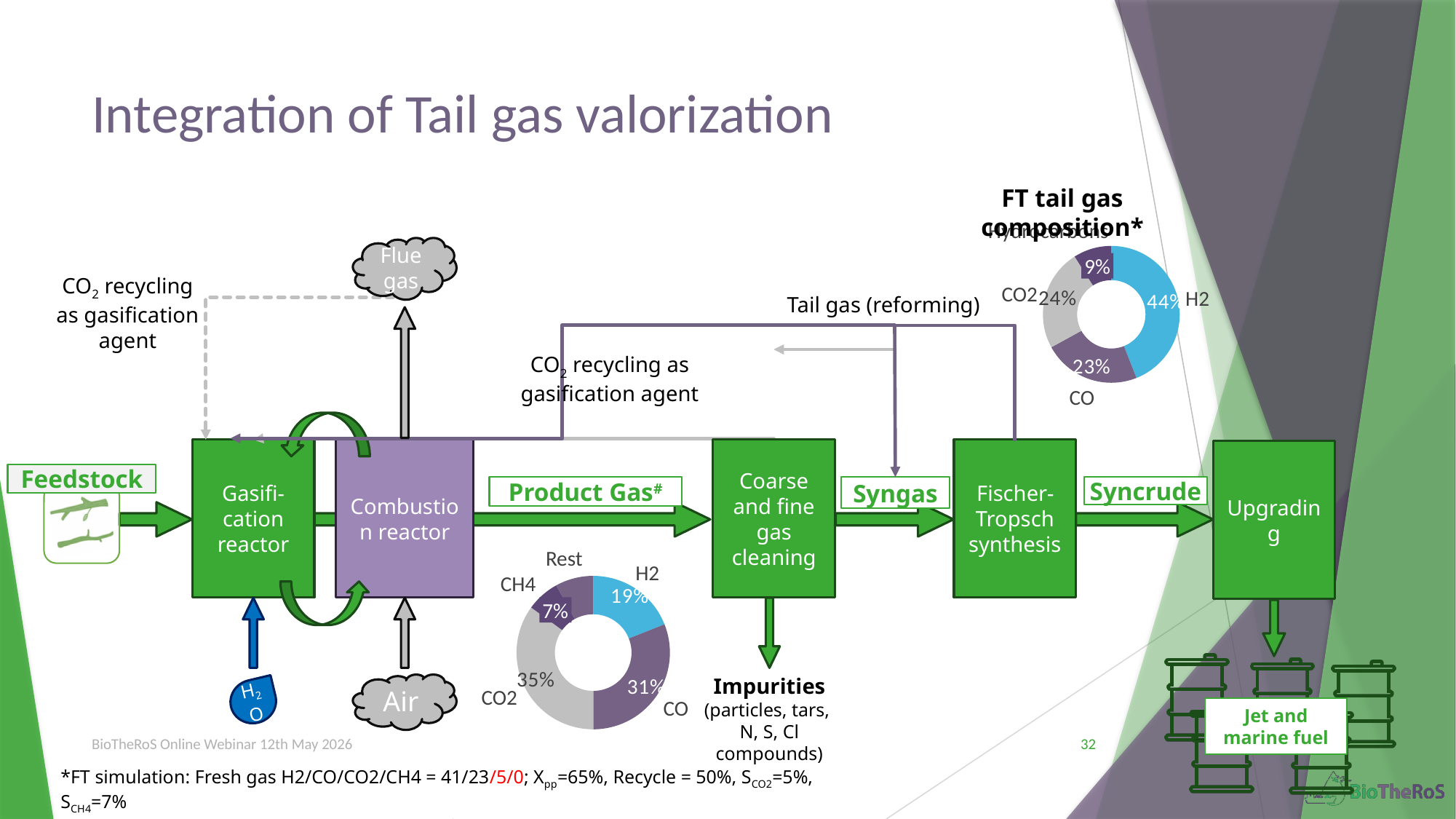
In the product gas composition donut chart in the lower middle of the slide, what share is CH4? 7% In the FT tail gas composition chart, what is the difference between the H2 share and the CO share? 21% In the FT tail gas composition chart, what share is CO2? 24% In the product gas composition donut chart in the lower middle of the slide, which is larger, the H2 share or the CO share? CO In the FT tail gas composition chart, what is the smallest slice's share? 9% In the FT tail gas composition chart, what share is H2? 44% What kind of chart is the FT tail gas composition chart? Donut (pie) chart In the FT tail gas composition chart, which component has the largest share? H2 How many slices does the product gas composition donut chart in the lower middle of the slide have? 5 In the FT tail gas composition chart, what share is CO? 23% In the product gas composition donut chart in the lower middle of the slide, what share is CO? 31% In the product gas composition donut chart in the lower middle of the slide, what share is CO2? 35%